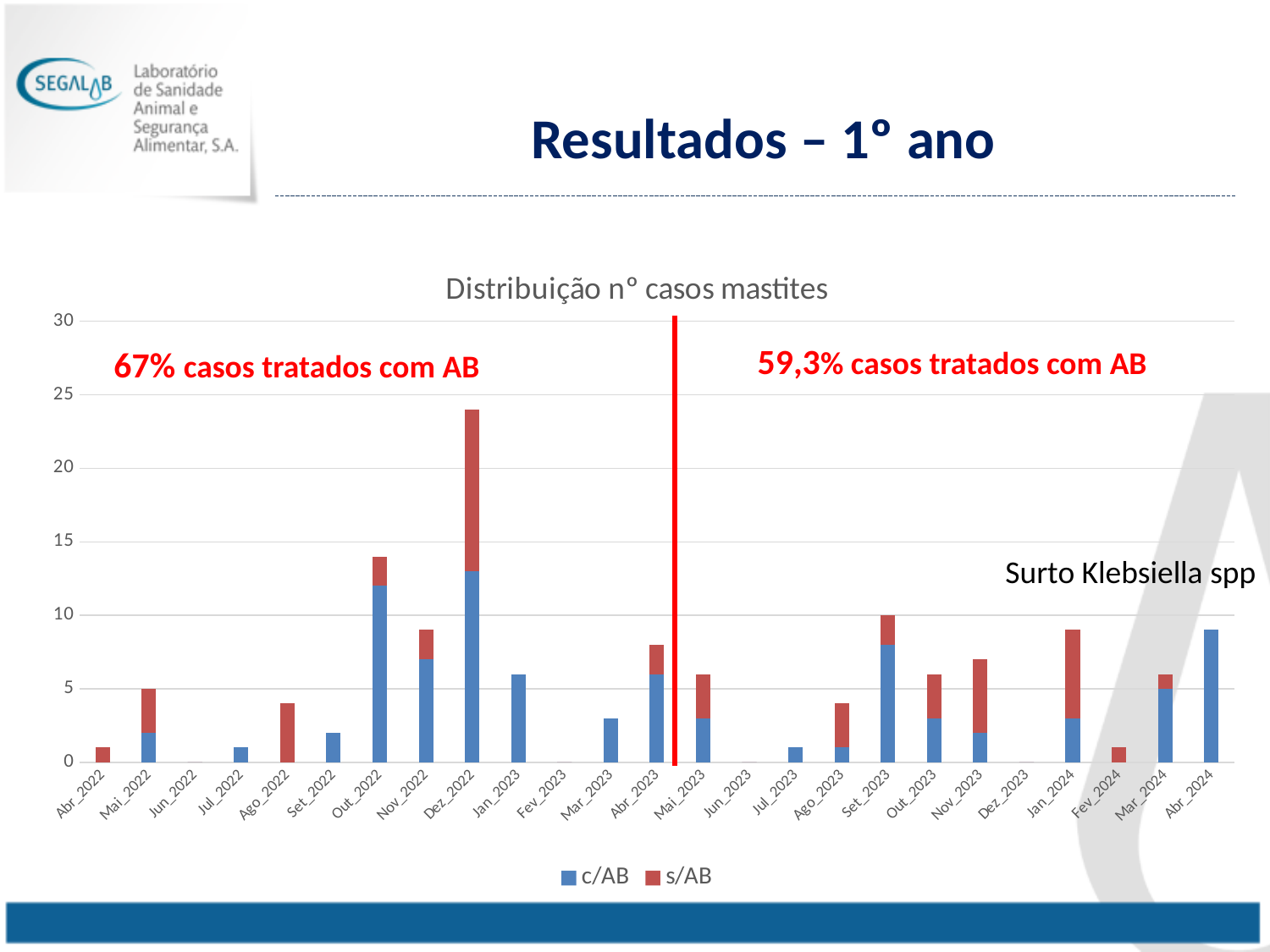
Is the value for Abr_2024 greater or less than 5? greater Which series is shown in red in the legend? s/AB Which month has the highest total number of cases? Dez_2022 What is the title of the chart? Distribuição nº casos mastites How many series does the legend list? 2 Is the value for Mar_2023 greater or less than 5? less What kind of chart is shown on the slide? Stacked bar chart Which month has the larger total, Dez_2022 or Out_2022? Dez_2022 Which month has the larger total, Abr_2024 or Fev_2024? Abr_2024 Is the total value for Out_2022 greater or less than 10? greater How many months are shown along the x axis? 25